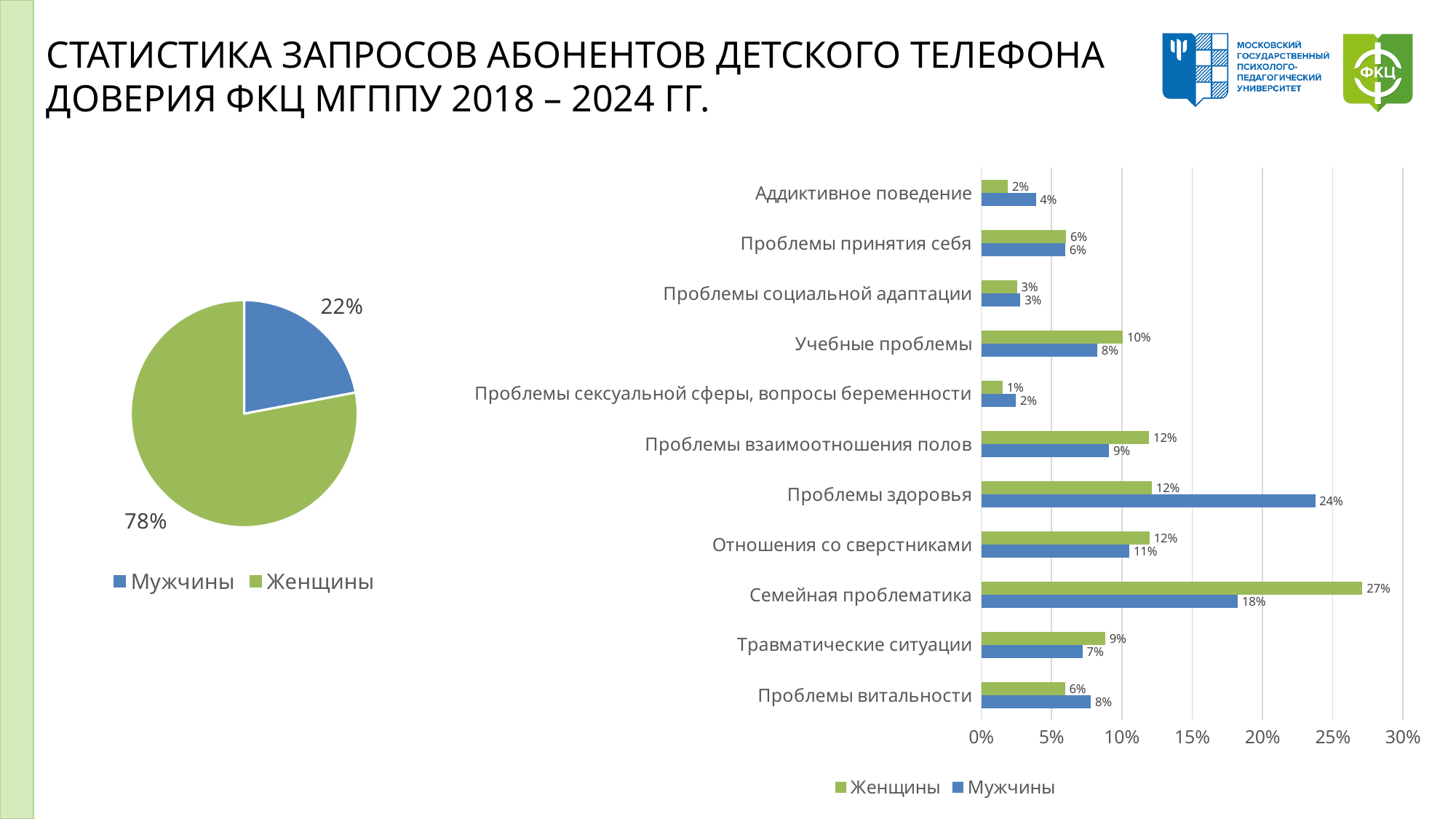
In the pie chart on the left, which group has the larger slice? Женщины In the bar chart on the right, what is the value for Женщины for Семейная проблематика? 27% How many categories are shown in the bar chart on the right? 11 In the pie chart on the left, what share is shown for Женщины? 78% What kind of chart is the chart on the right side of the slide? Bar chart In the bar chart on the right, what is the value for Мужчины for Проблемы здоровья? 24% In the bar chart on the right, which category has the lowest value for Женщины? Проблемы сексуальной сферы, вопросы беременности In the pie chart on the left, what share is shown for Мужчины? 22% How many series does the legend of the bar chart on the right list? 2 In the bar chart on the right, what is the difference between the Женщины and Мужчины values for Семейная проблематика? 9% In the bar chart on the right, which category has the highest value for Мужчины? Проблемы здоровья In the bar chart on the right, which is larger for Учебные проблемы: the value for Женщины or for Мужчины? Женщины